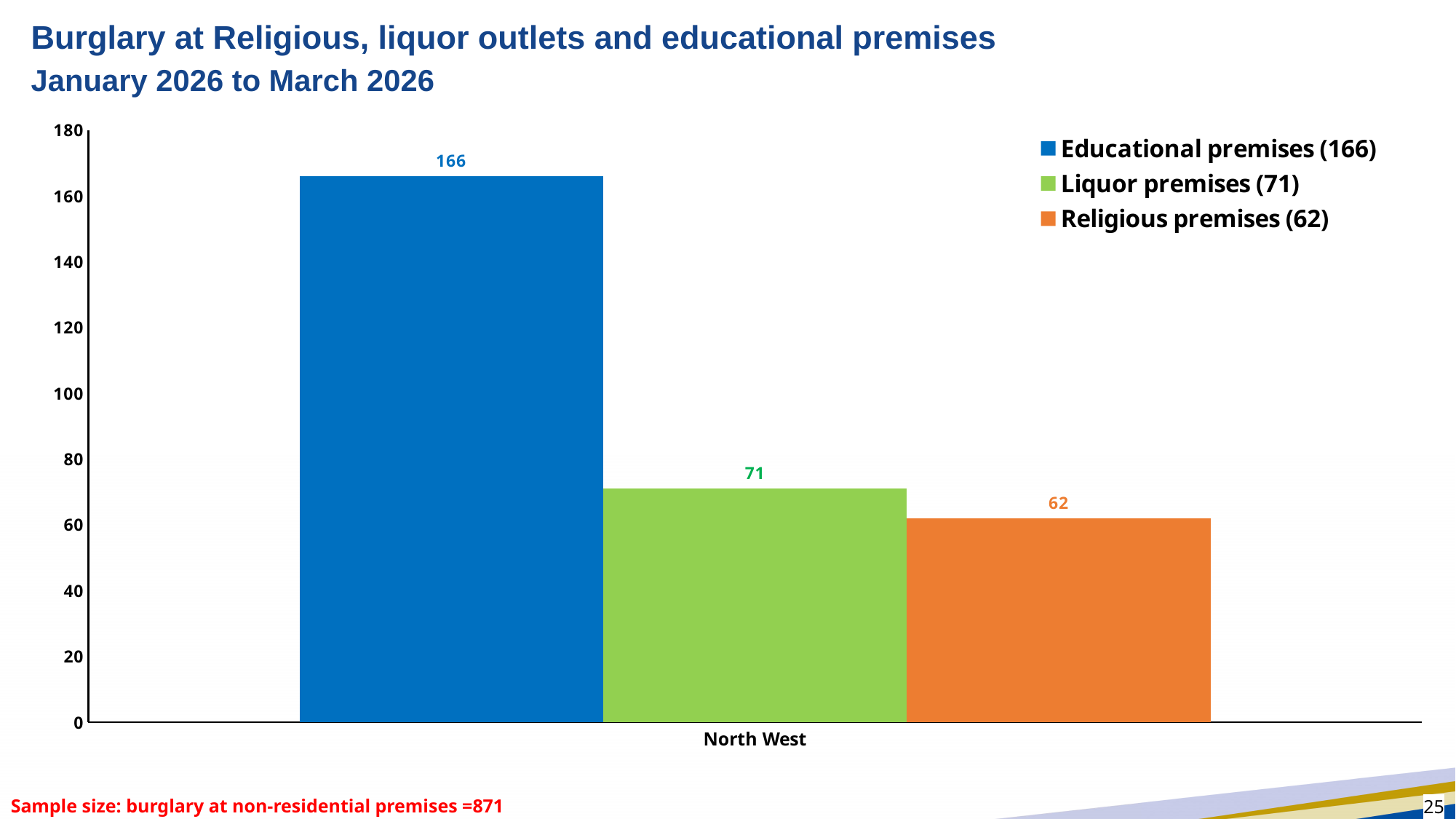
Which is larger, the value for Liquor premises or the value for Religious premises? Liquor premises What kind of chart is shown on the slide? Bar chart What is the value for Religious premises in North West? 62 Which series has the lowest value? Religious premises How many series does the legend list? 3 Which series has the highest value? Educational premises What is the difference between the Liquor premises value and the Religious premises value? 9 Is the value for Educational premises greater or less than 140? greater What is the title of the chart? Burglary at Religious, liquor outlets and educational premises What is the value for Educational premises in North West? 166 What is the value for Liquor premises in North West? 71 What is the difference between the Educational premises value and the Liquor premises value? 95